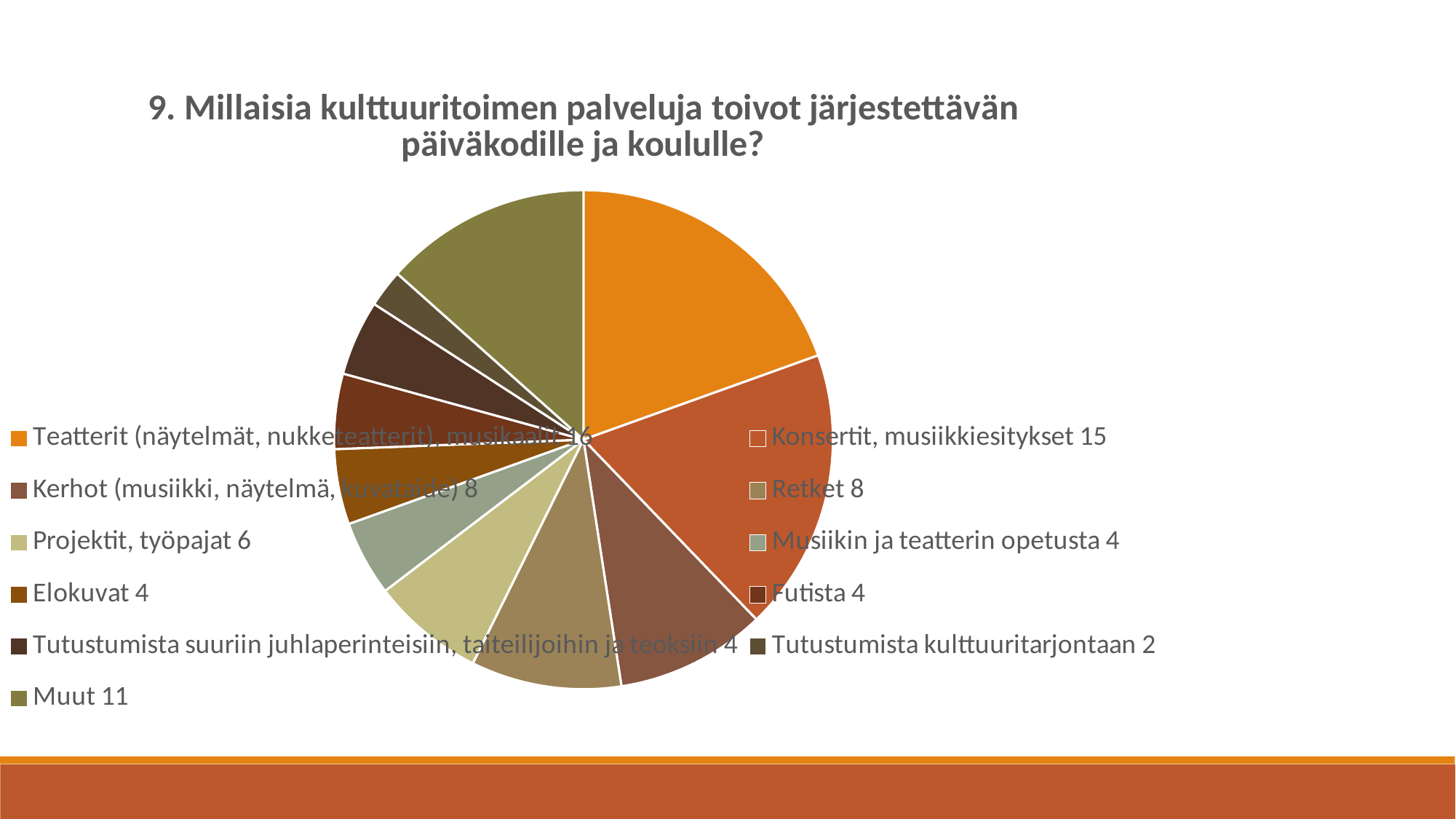
Which category has the highest value? Teatterit (näytelmät, nukketeatterit), musikaalit Which category has the lowest value? Tutustumista kulttuuritarjontaan What is the value for Konsertit, musiikkiesitykset? 15 What is the value for Projektit, työpajat? 6 How many categories does the pie chart have? 11 Which is larger, the value for Retket or the value for Elokuvat? Retket What type of chart is shown on the slide? pie chart What is the title of the chart? 9. Millaisia kulttuuritoimen palveluja toivot järjestettävän päiväkodille ja koululle? What is the total of all the values shown in the legend? 82 What is the difference between the values for Teatterit (näytelmät, nukketeatterit), musikaalit and Muut? 5 What is the value for Tutustumista kulttuuritarjontaan? 2 What is the value for Muut? 11